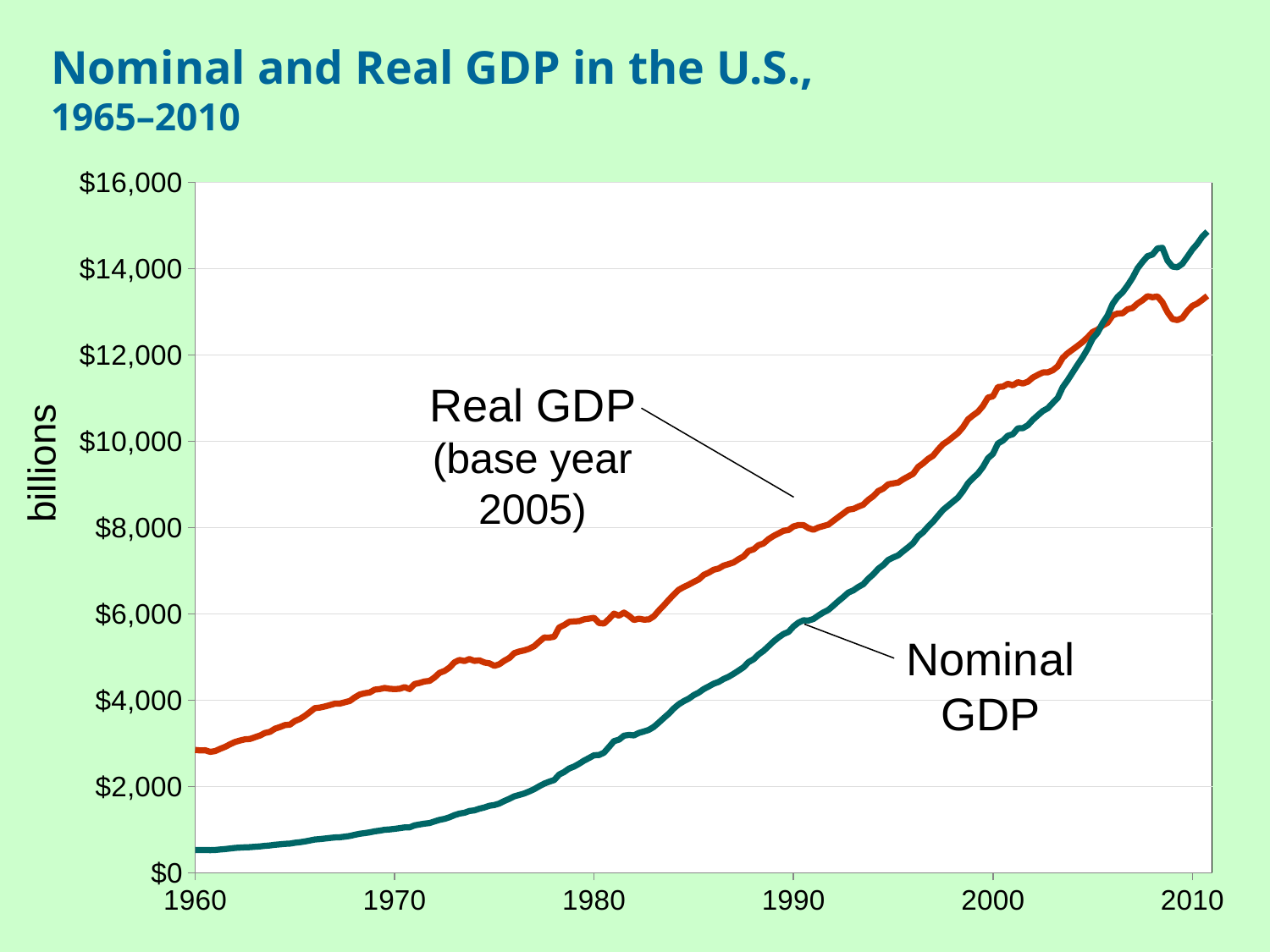
Is the value for Nominal GDP in 2010 greater or less than $14,000? greater What kind of chart is shown on the slide? line chart How many series are plotted on the chart? 2 Is the value for Real GDP in 2000 greater or less than $10,000? greater What is the title of the chart? Nominal and Real GDP in the U.S., 1965–2010 Is the value for Nominal GDP in 1980 greater or less than $4,000? less What is the label on the vertical axis? billions In 2010, which series has the higher value, Real GDP or Nominal GDP? Nominal GDP In 1980, which series has the higher value, Real GDP or Nominal GDP? Real GDP Does Nominal GDP generally rise or fall from 1960 to 2010? rise